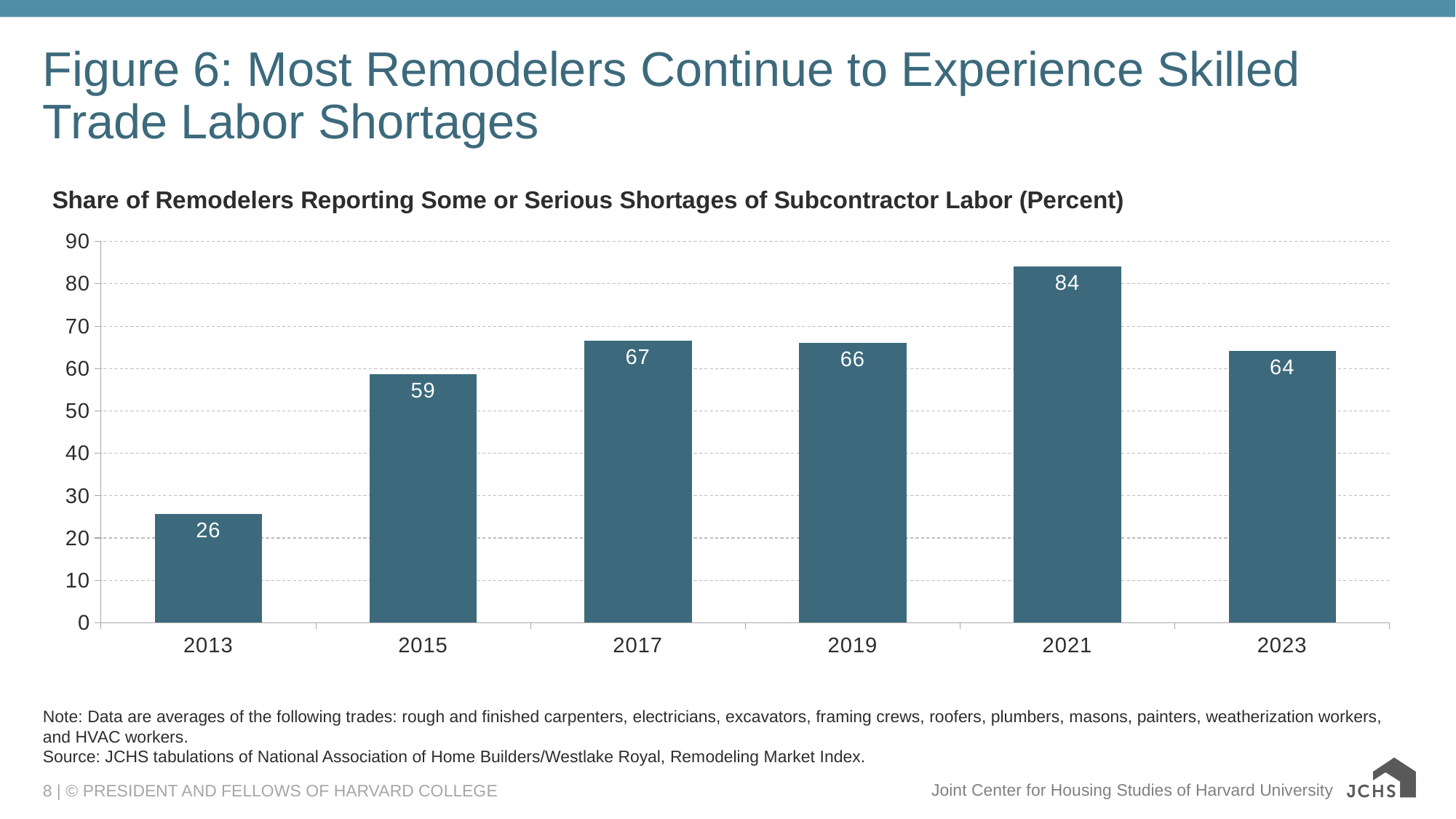
By how much did the share increase from 2013 to 2015? 33 Which year has the highest share of remodelers reporting shortages? 2021 Which year has the lowest value? 2013 What kind of chart is shown on the slide? Bar chart What value is shown for 2021? 84 What is the value for 2023? 64 How many years are shown on the x axis? 6 Which is larger, the value for 2017 or the value for 2019? 2017 What is the title of the chart? Share of Remodelers Reporting Some or Serious Shortages of Subcontractor Labor (Percent) What is the difference between the values for 2021 and 2023? 20 What is the share of remodelers reporting shortages in 2013? 26 Is the value for 2015 greater or less than 50? greater